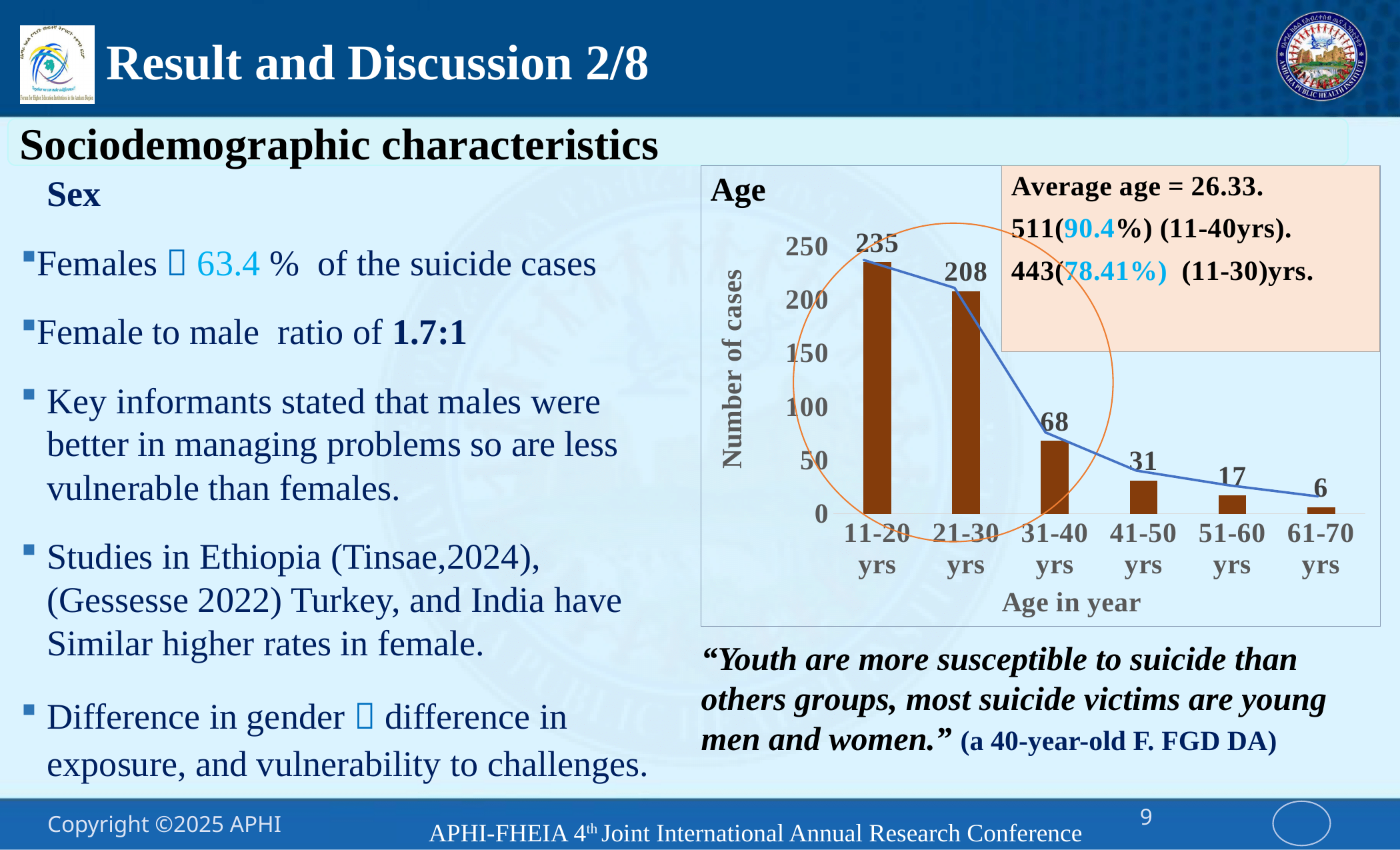
Which age group has more cases, 41-50 yrs or 51-60 yrs? 41-50 yrs What is the number of cases for the 51-60 yrs age group? 17 What is the number of cases for the 11-20 yrs age group? 235 How many age groups are shown on the x axis of the chart? 6 What is the difference in number of cases between the 31-40 yrs and 41-50 yrs age groups? 37 What is the label of the y axis of the chart? Number of cases What is the number of cases for the 31-40 yrs age group? 68 What is the difference in number of cases between the 11-20 yrs and 21-30 yrs age groups? 27 Is the number of cases for the 21-30 yrs age group greater or less than 200? greater Which age group has the highest number of cases? 11-20 yrs Do the number of cases rise or fall as age increases along the x axis? fall Which age group has the lowest number of cases? 61-70 yrs